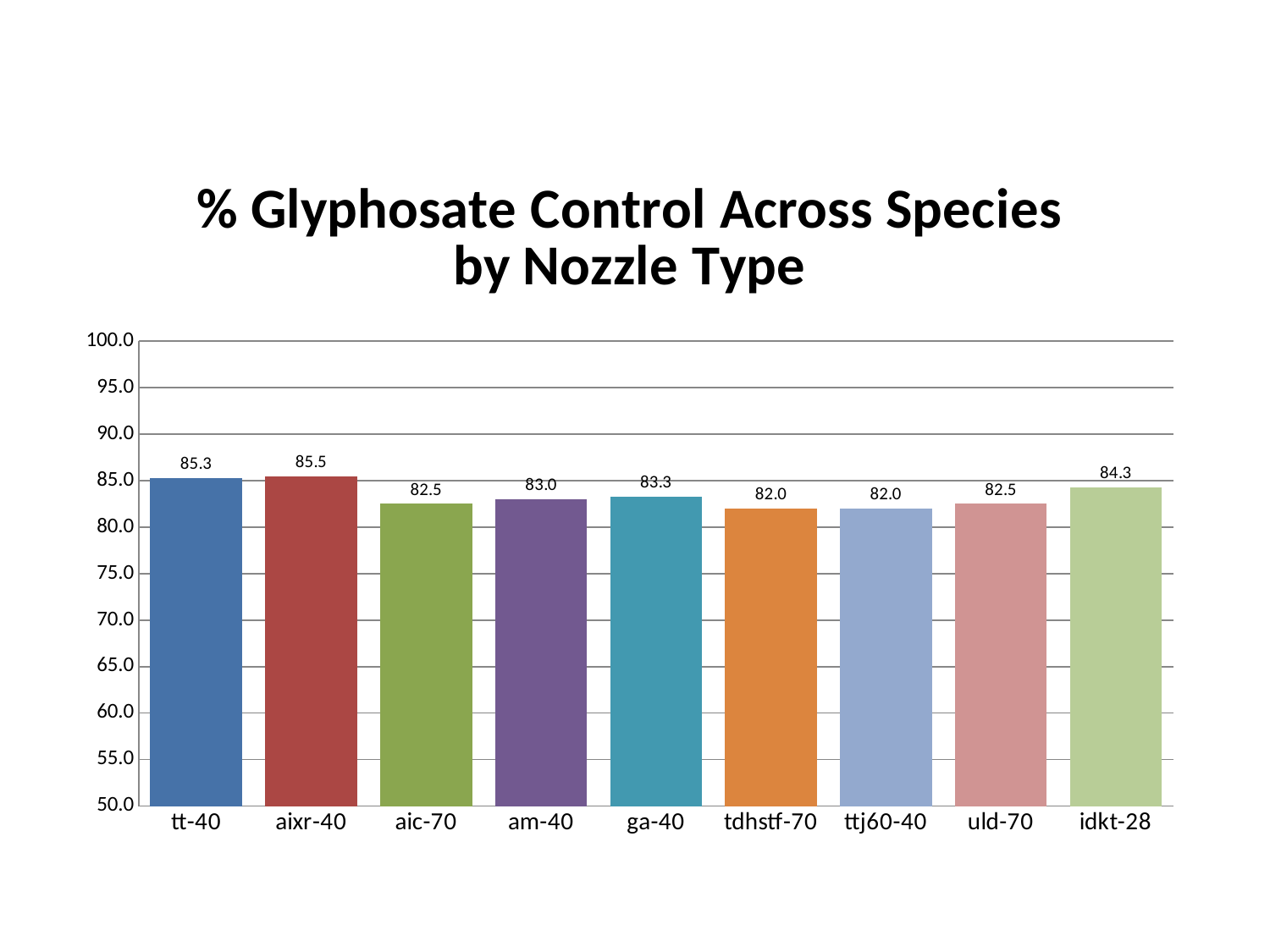
What is the value for tt-40? 85.3 What is the value for ga-40? 83.3 How many nozzle types are shown on the x axis? 9 What is the difference between the values for aixr-40 and tdhstf-70? 3.5 Is the value for ttj60-40 greater or less than 90.0? less What is the value for idkt-28? 84.3 What kind of chart is shown on the slide? bar chart Which is larger, the value for tt-40 or the value for aic-70? tt-40 What is the difference between the values for idkt-28 and aic-70? 1.8 What is the title of the chart? % Glyphosate Control Across Species by Nozzle Type Which nozzle type has the highest value? aixr-40 What is the value for uld-70? 82.5